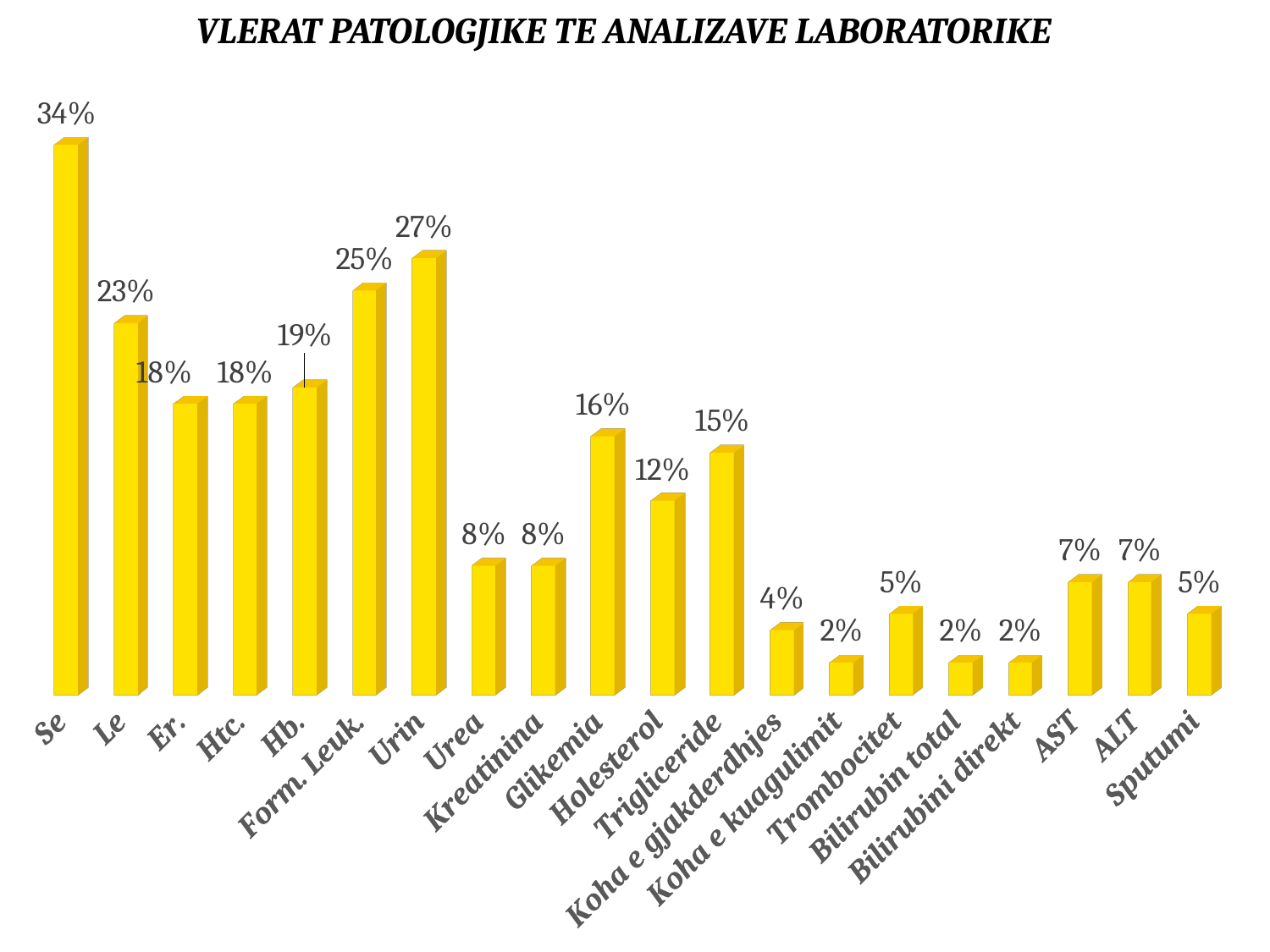
What is the lowest value shown on the chart? 2% Which category has the highest value? Se Which is larger, the value for Form. Leuk. or the value for Urin? Urin What is the difference between the values for Se and Le? 11% What is the value for Koha e gjakderdhjes? 4% What is the title of the chart? VLERAT PATOLOGJIKE TE ANALIZAVE LABORATORIKE What is the value for Se? 34% What is the value for Trigliceride? 15% What kind of chart is this? Bar chart What is the value for Urin? 27% How many categories are shown on the chart? 20 What is the difference between the values for Glikemia and Holesterol? 4%